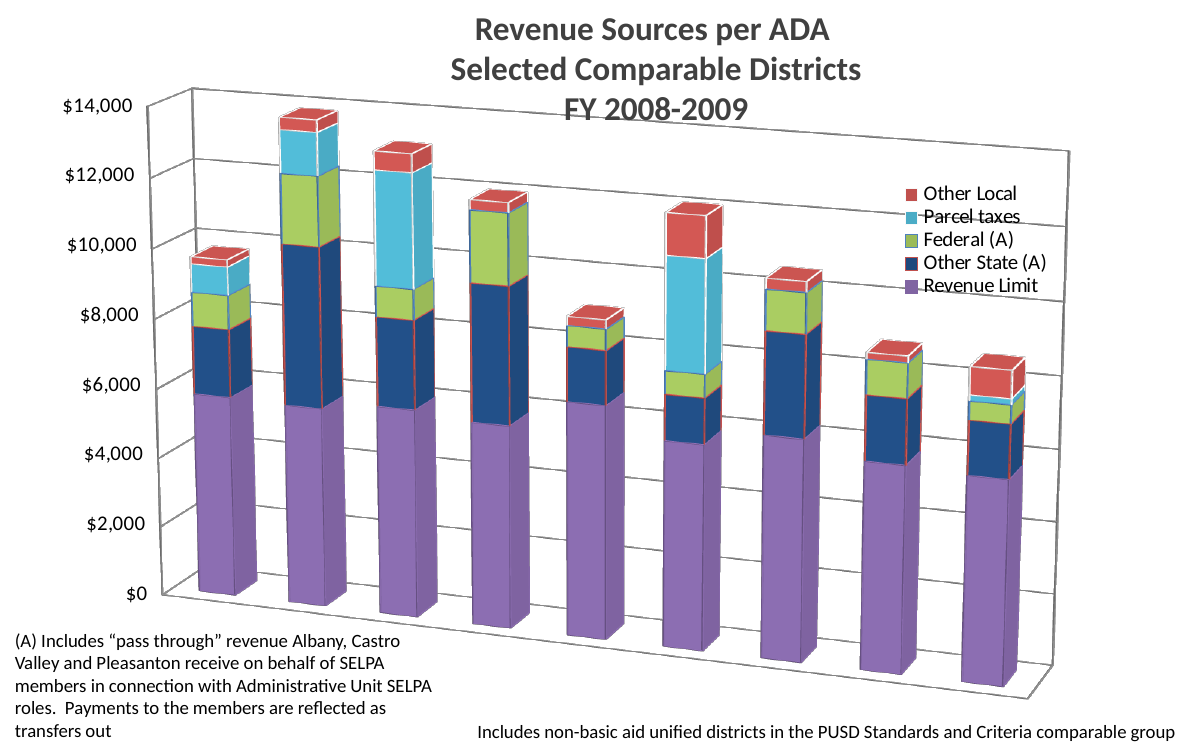
Which fiscal year does the chart title say the data covers? FY 2008-2009 What kind of chart is shown on the slide? Stacked bar chart Is the total for the leftmost bar greater or less than $10,000? less Which has the larger total: the leftmost bar or the second bar from the left? The second bar from the left Is the total for the second bar from the left greater or less than $12,000? greater Which bar has the highest total revenue per ADA? The second bar from the left Is the total for the sixth bar from the left greater or less than $10,000? greater Which series appears at the bottom of each stacked bar? Revenue Limit How many bars (districts) are plotted in the chart? 9 Which has the larger total: the sixth bar from the left or the seventh bar from the left? The sixth bar from the left How many series does the legend list? 5